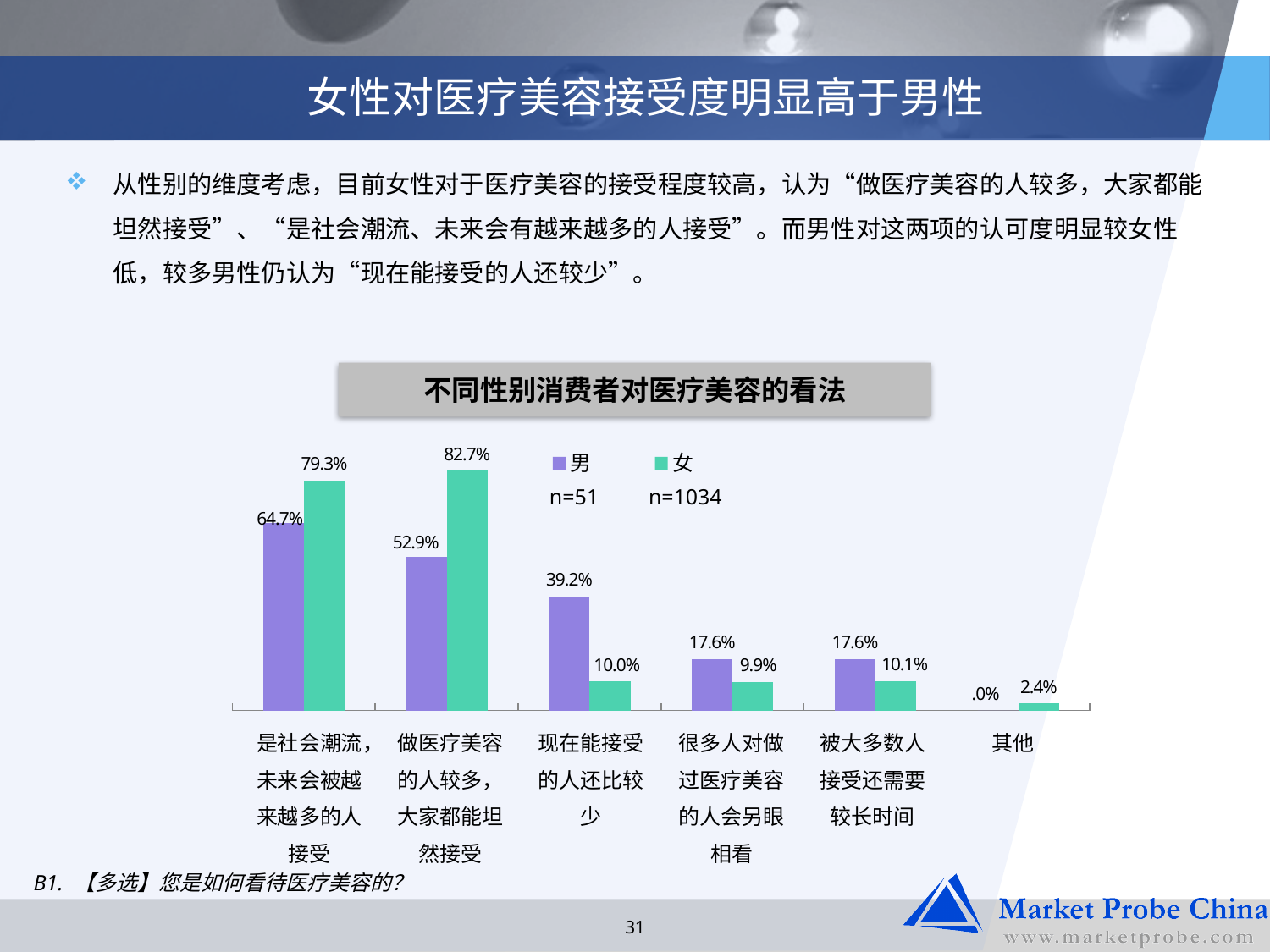
How many series does the legend list? 2 What is the difference between the 女 and 男 values in the category 是社会潮流，未来会被越来越多的人接受? 14.6% What is the title of the chart? 不同性别消费者对医疗美容的看法 In the category 现在能接受的人还比较少, which series has the larger value, 男 or 女? 男 Which category has the highest value for the 女 series? 做医疗美容的人较多，大家都能坦然接受 What is the sample size (n) for the 女 series shown in the legend? n=1034 What is the value for 女 in the category 做医疗美容的人较多，大家都能坦然接受? 82.7% What kind of chart is shown on the slide? bar chart How many categories are shown on the x axis of the chart? 6 What is the value for 女 in the category 其他? 2.4% Which category has the lowest value for the 男 series? 其他 What is the value for 男 in the category 现在能接受的人还比较少? 39.2%